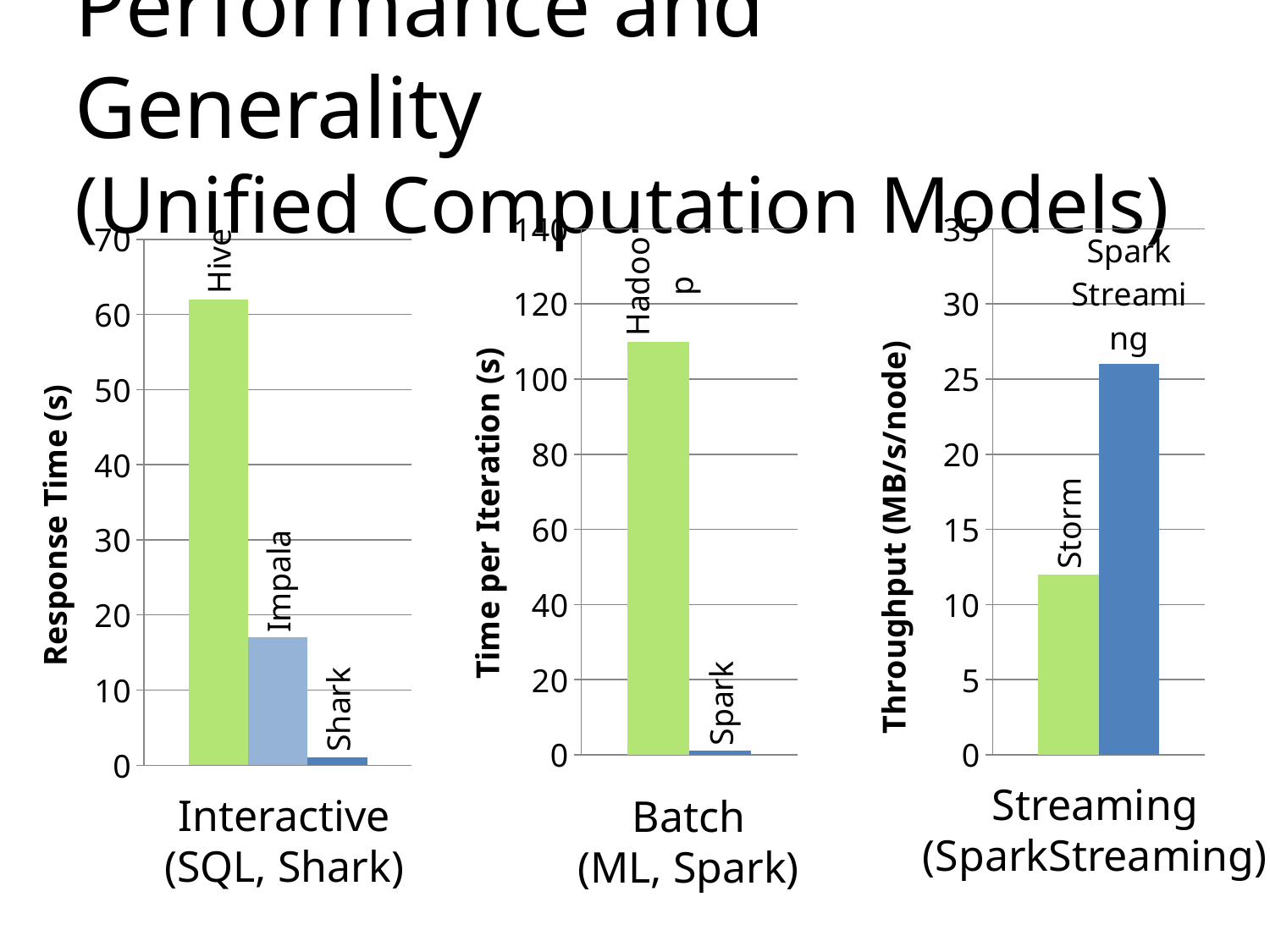
How many bars are plotted in the Interactive (SQL, Shark) chart? 3 In the Streaming (SparkStreaming) chart, is the value for Storm greater or less than 15? less In the Batch (ML, Spark) chart, which system has the highest time per iteration? Hadoop In the Streaming (SparkStreaming) chart, which has the higher throughput, Storm or Spark Streaming? Spark Streaming In the Interactive (SQL, Shark) chart, which system has the highest response time? Hive In the Batch (ML, Spark) chart, is the value for Hadoop greater or less than 100? greater What is the y-axis label of the Streaming (SparkStreaming) chart? Throughput (MB/s/node) In the Interactive (SQL, Shark) chart, which system has the lowest response time? Shark In the Interactive (SQL, Shark) chart, is the value for Hive greater or less than 60? greater